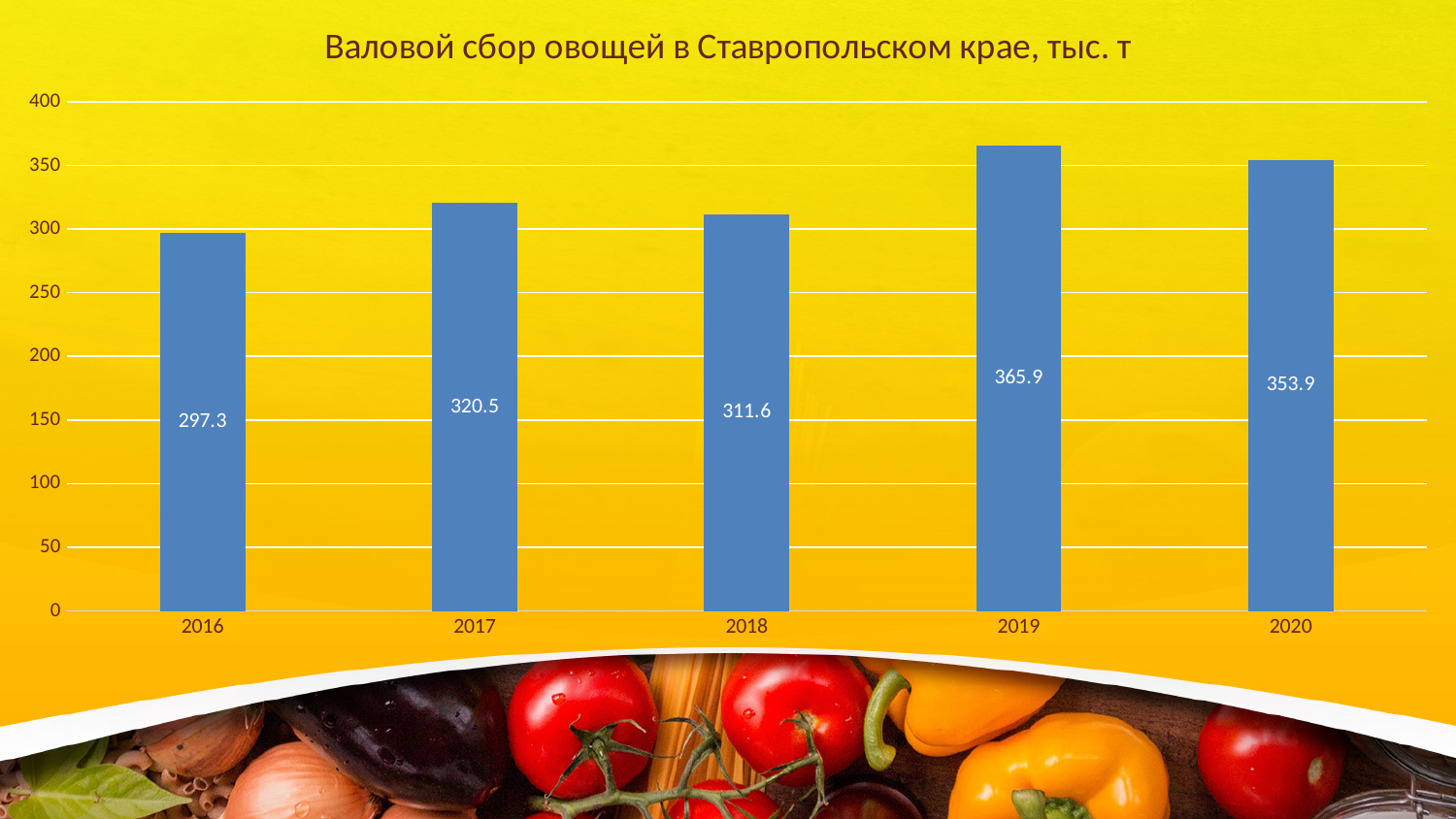
What is the value for 2016? 297.3 What is the difference between the values for 2019 and 2020? 12.0 What is the value for 2020? 353.9 How many years are shown on the x axis? 5 Which is larger, the value for 2017 or the value for 2018? 2017 Which year has the lowest value? 2016 Is the value for 2019 greater or less than 350? greater What is the difference between the values for 2017 and 2016? 23.2 What kind of chart is this? bar chart What is the title of the chart? Валовой сбор овощей в Ставропольском крае, тыс. т Which year has the highest value? 2019 What is the value for 2019? 365.9